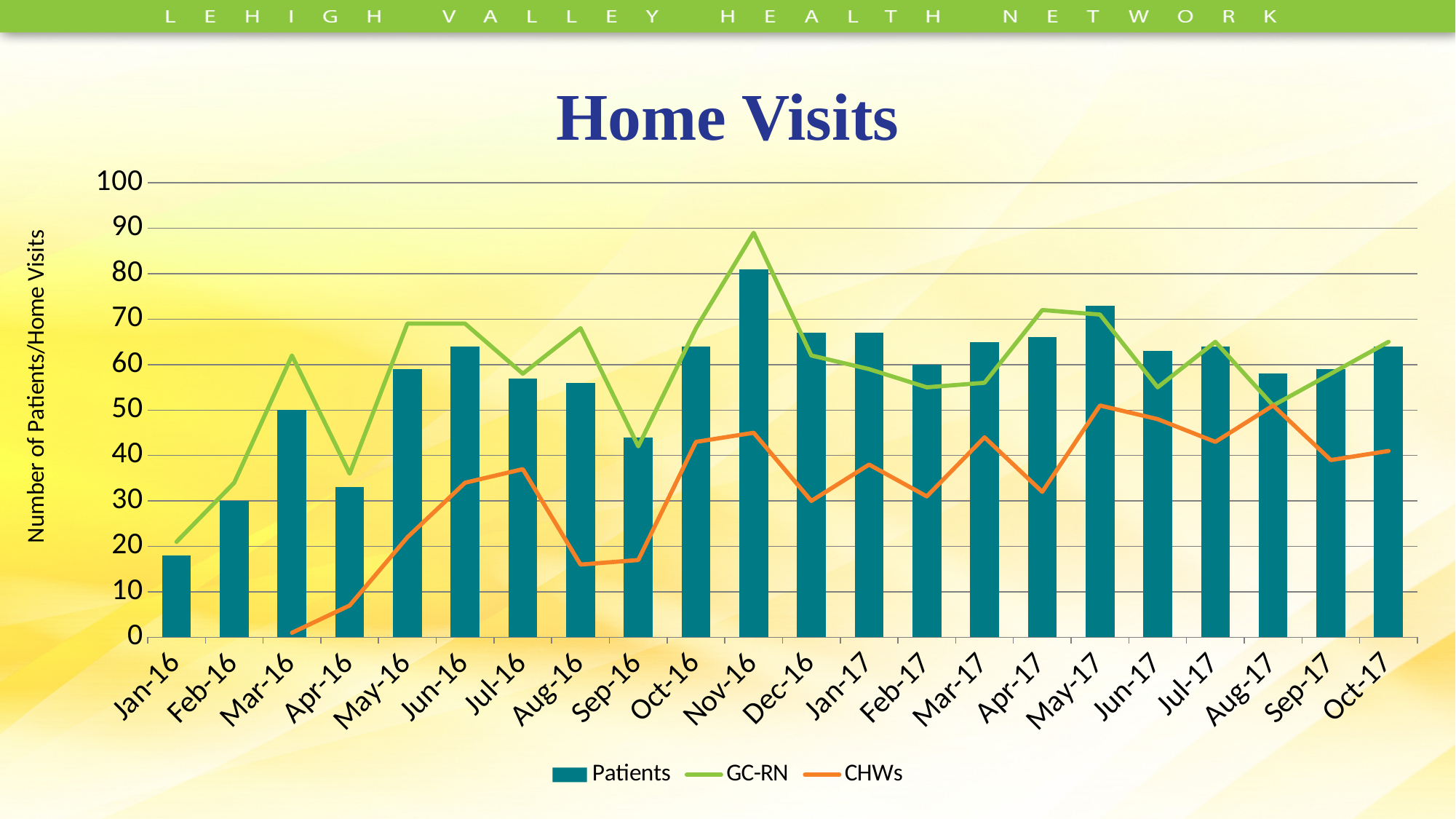
Is the number of Patients in Sep-16 greater or less than 50? less What is the number of Patients in Feb-16? 30 Which month has the lowest number of Patients? Jan-16 In which month does the GC-RN line reach its highest value? Nov-16 How many months are shown on the x axis? 22 What is the number of Patients in Mar-16? 50 Which month has the highest number of Patients? Nov-16 In which month does the CHWs line have its lowest value? Mar-16 Which month has more Patients, Nov-16 or Dec-16? Nov-16 How many series does the legend list? 3 Is the number of Patients in Nov-16 greater or less than 70? greater What type of chart is shown on the slide? Combined bar and line chart